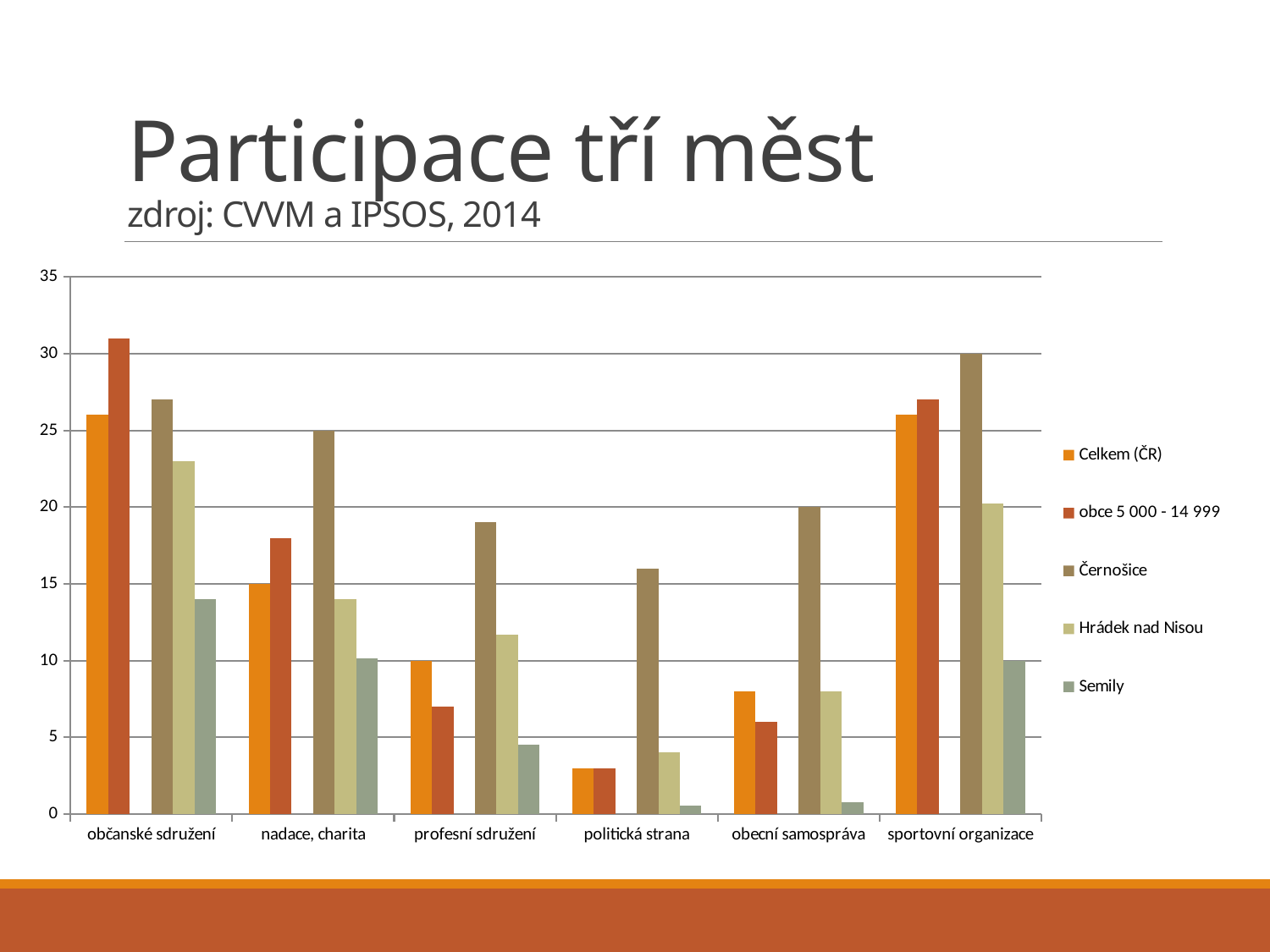
What is the title of the slide containing the chart? Participace tří měst What is the value for Černošice in the sportovní organizace category? 30 In the nadace, charita category, which is larger: Celkem (ČR) or obce 5 000 - 14 999? obce 5 000 - 14 999 How many categories are shown on the x axis? 6 Which series has the lowest value in the občanské sdružení category? Semily Is the value for obce 5 000 - 14 999 in the občanské sdružení category greater or less than 30? greater Is the value for Semily in the politická strana category greater or less than 5? less What kind of chart is shown on the slide? bar chart Which series has the highest value in the politická strana category? Černošice How many series does the legend list? 5 What is the value for Celkem (ČR) in the nadace, charita category? 15 What is the value for Černošice in the obecní samospráva category? 20